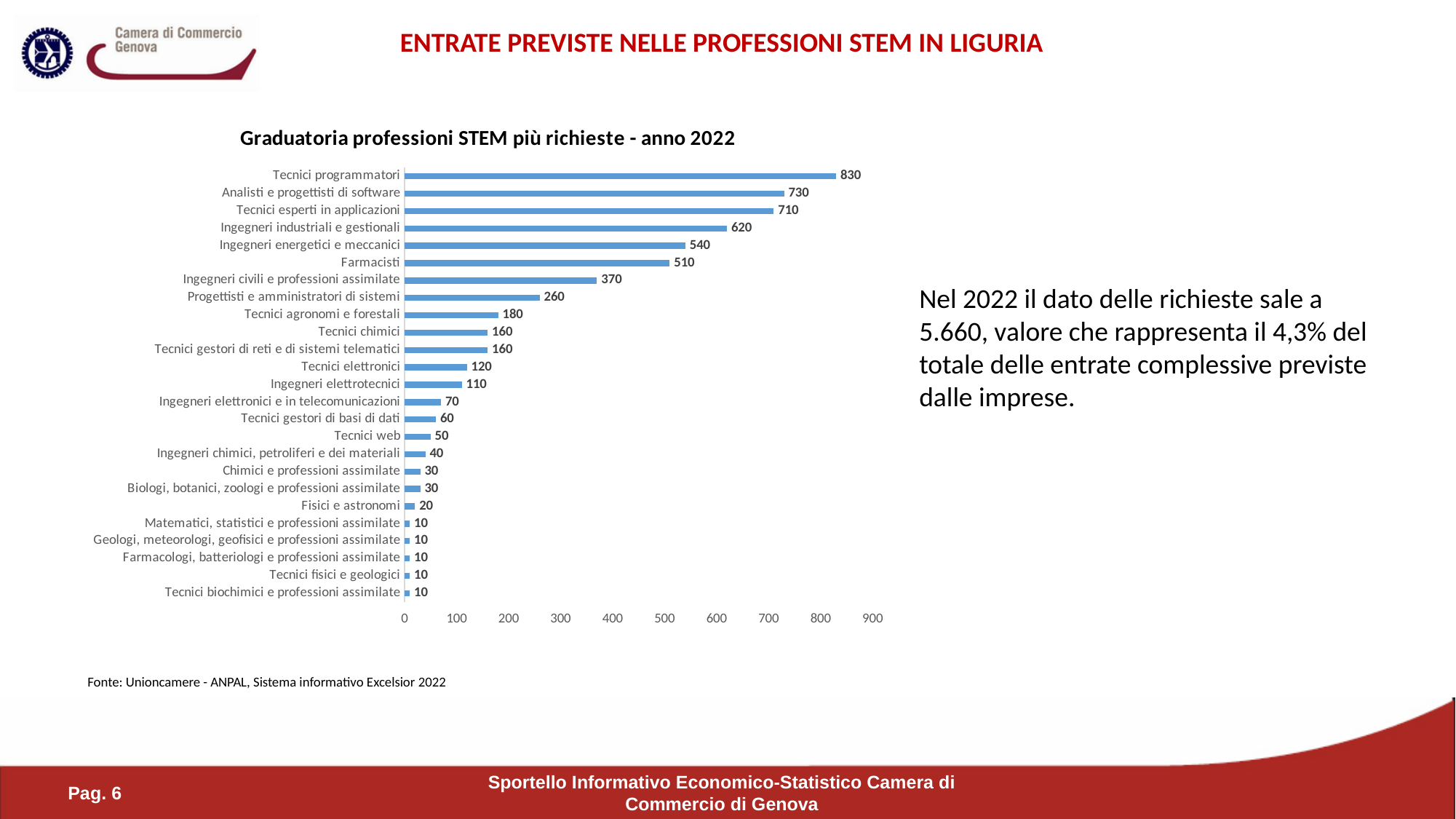
What is the value for Ingegneri civili e professioni assimilate? 370 What is the value for Tecnici programmatori? 830 What is the difference between the values for Analisti e progettisti di software and Tecnici esperti in applicazioni? 20 What is the value for Farmacisti? 510 Which is larger, the value for Progettisti e amministratori di sistemi or the value for Tecnici agronomi e forestali? Progettisti e amministratori di sistemi What is the title of the chart? Graduatoria professioni STEM più richieste - anno 2022 What is the difference between the values for Ingegneri industriali e gestionali and Ingegneri energetici e meccanici? 80 Is the value for Ingegneri energetici e meccanici greater or less than 500? greater What kind of chart is shown on the slide? bar chart How many professions are shown in the chart? 25 Which profession has the highest value? Tecnici programmatori What is the value for Tecnici web? 50